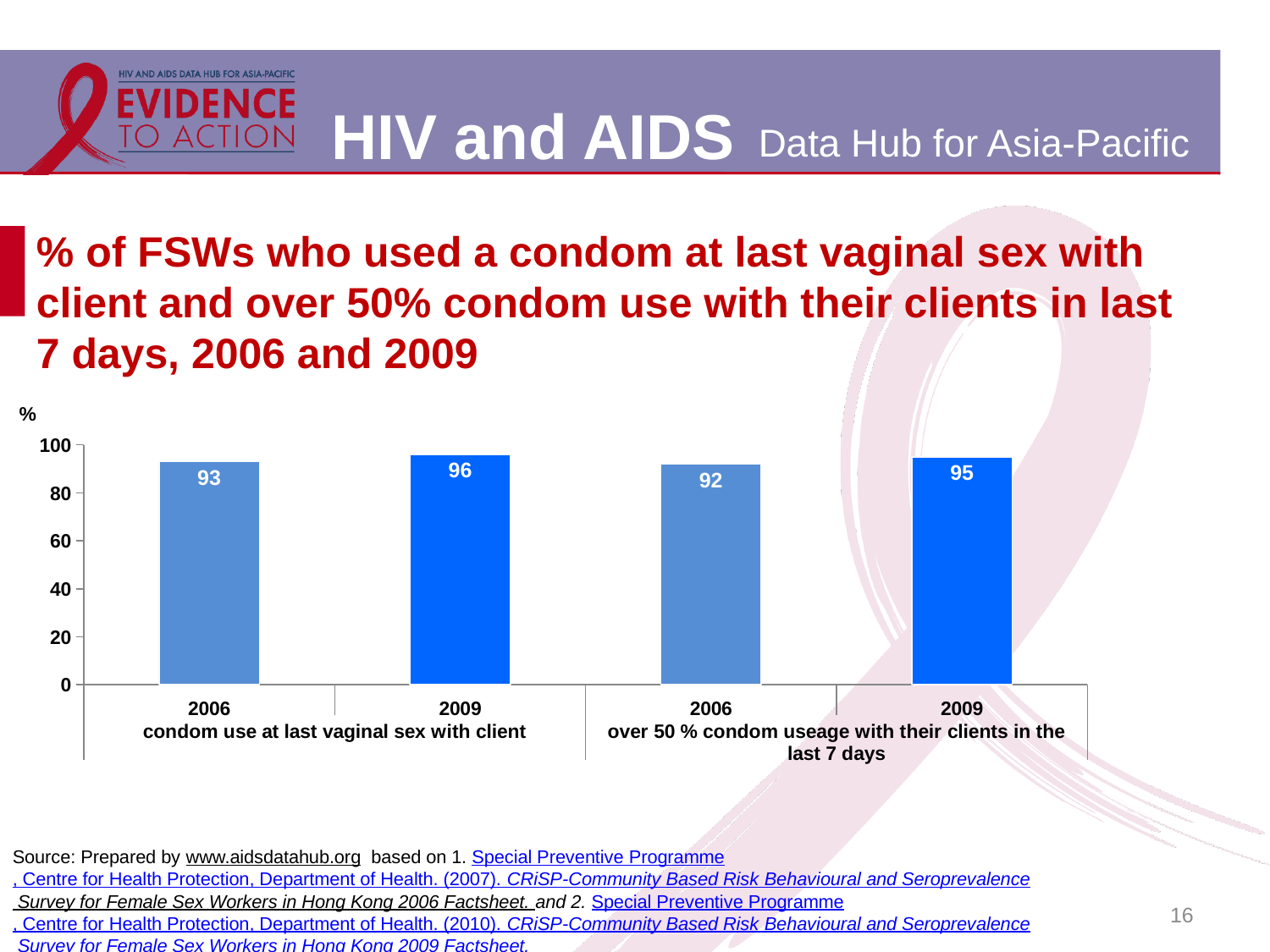
What is the difference between the 2009 and 2006 values for 'over 50 % condom useage with their clients in the last 7 days'? 3 Which bar has the highest value? 2009, condom use at last vaginal sex with client What is the value for 2006 under 'over 50 % condom useage with their clients in the last 7 days'? 92 Which is larger: the 2006 value for 'condom use at last vaginal sex with client' or the 2006 value for 'over 50 % condom useage with their clients in the last 7 days'? condom use at last vaginal sex with client What is the value for 2009 under 'condom use at last vaginal sex with client'? 96 What kind of chart is shown on the slide? bar chart What is the value for 2006 under 'condom use at last vaginal sex with client'? 93 What is the label on the vertical axis of the chart? % Which bar has the lowest value? 2006, over 50 % condom useage with their clients in the last 7 days What is the difference between the 2009 and 2006 values for 'condom use at last vaginal sex with client'? 3 What is the value for 2009 under 'over 50 % condom useage with their clients in the last 7 days'? 95 How many bars are plotted in the chart? 4